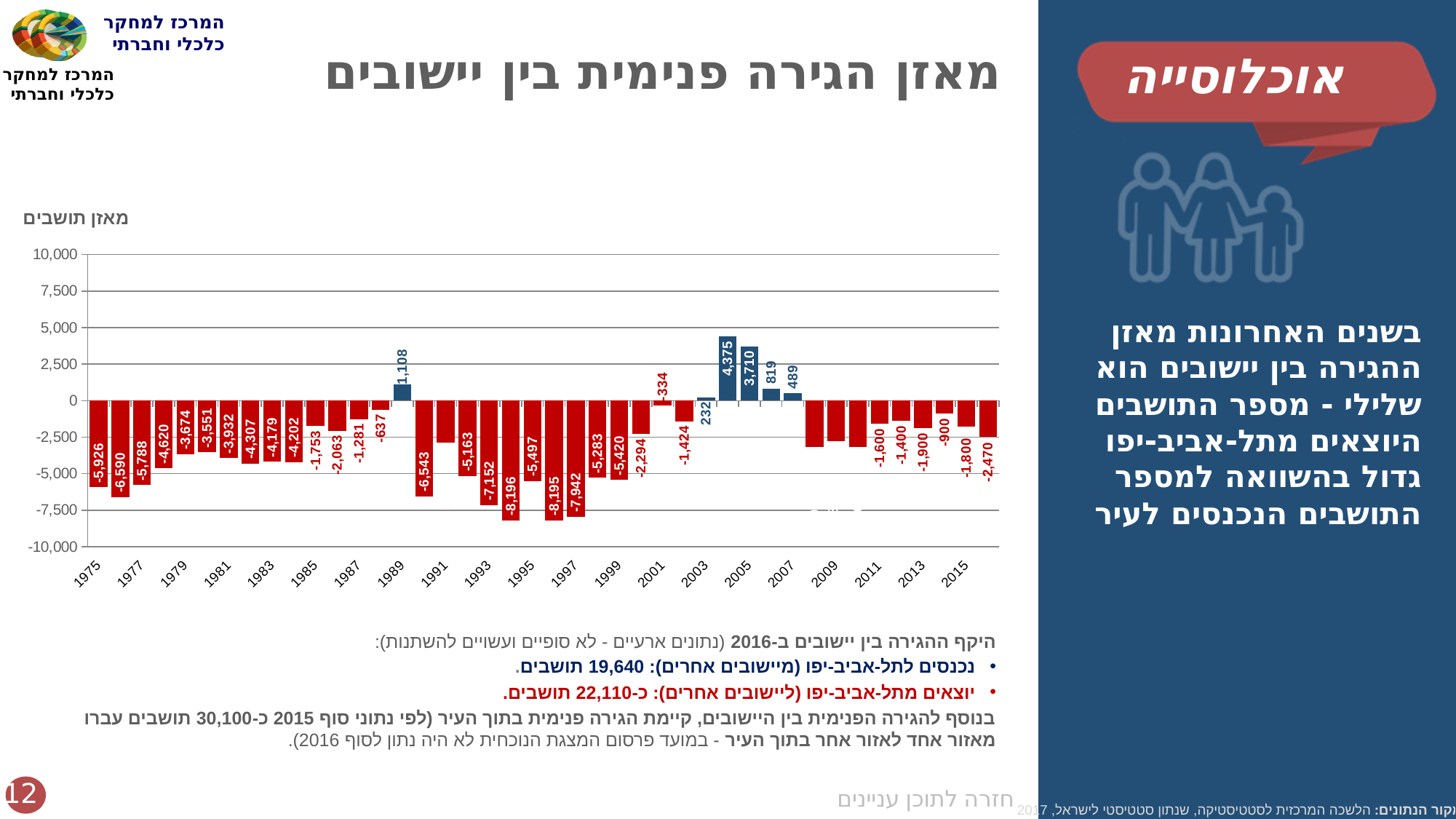
What is the migration balance value shown for 1989? 1,108 What is the difference between the values for 2004 and 2005? 665 Do the values rise or fall from 2004 to 2007? fall What is the migration balance value shown for 2016? -2,470 What type of chart is shown on the slide? bar chart What is the migration balance value shown for 2004? 4,375 How many years in the chart have a positive (blue) migration balance? 6 What is the migration balance value shown for 2014? -900 Which year has the highest migration balance in the chart? 2004 Is the value for 2008 greater or less than -5,000? greater Which year has the more negative migration balance, 1976 or 1977? 1976 What is the migration balance value shown for 1975? -5,926